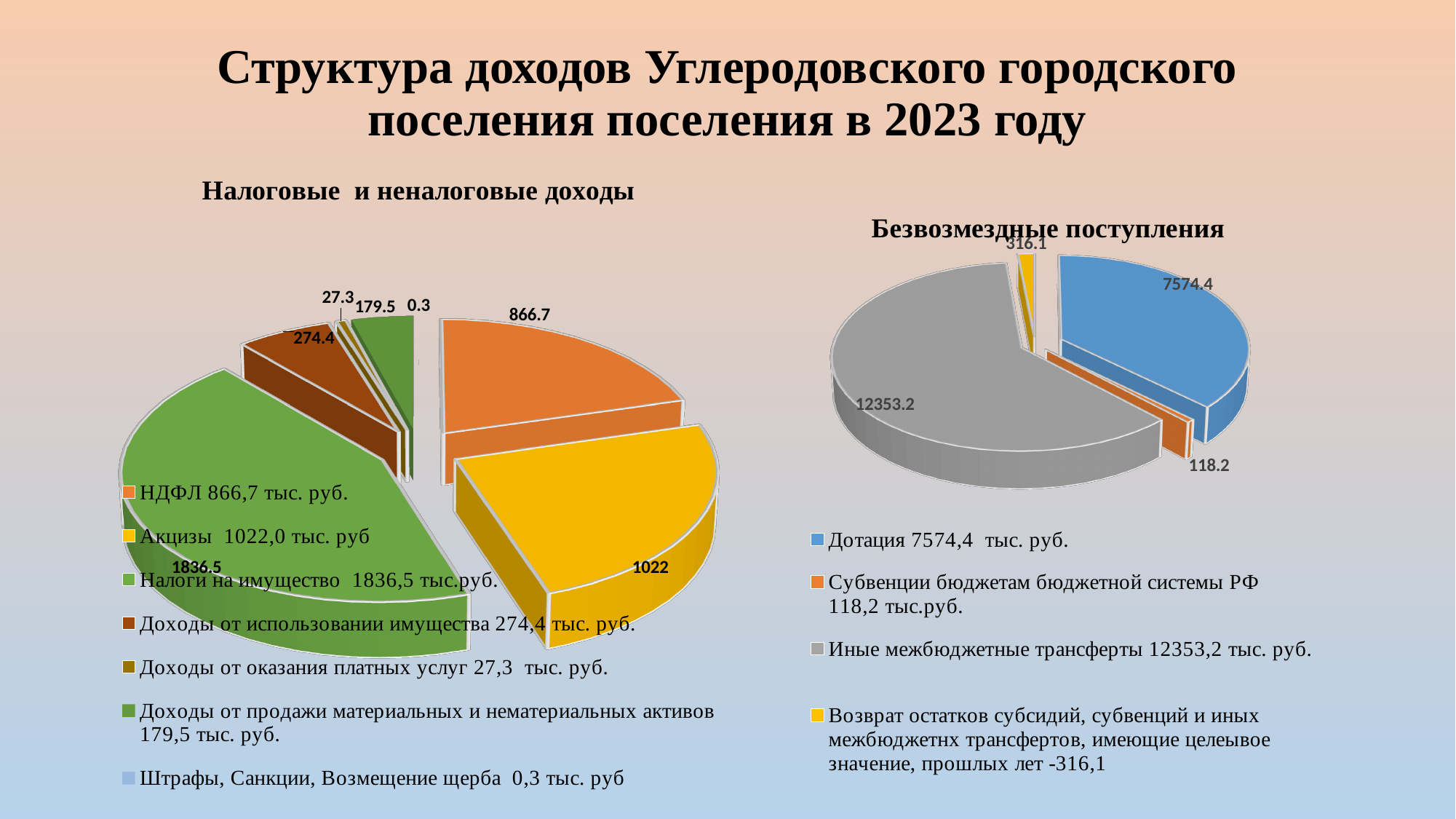
How many categories does the legend of the chart titled "Безвозмездные поступления" list? 4 On the chart titled "Безвозмездные поступления", what is the difference between the values for Иные межбюджетные трансферты and Дотация? 4778.8 On the chart titled "Безвозмездные поступления", what value is shown for Дотация? 7574.4 On the chart titled "Налоговые и неналоговые доходы", which category has the largest slice? Налоги на имущество On the chart titled "Налоговые и неналоговые доходы", what is the difference between the values for Налоги на имущество and Акцизы? 814.5 On the chart titled "Налоговые и неналоговые доходы", which is larger: Доходы от использовании имущества or Доходы от продажи материальных и нематериальных активов? Доходы от использовании имущества On the chart titled "Безвозмездные поступления", which category has the largest slice? Иные межбюджетные трансферты On the chart titled "Безвозмездные поступления", what value is shown for Субвенции бюджетам бюджетной системы РФ? 118.2 What type of chart is the chart titled "Налоговые и неналоговые доходы"? Pie chart On the chart titled "Налоговые и неналоговые доходы", what value is shown for Налоги на имущество? 1836.5 On the chart titled "Налоговые и неналоговые доходы", which category has the smallest value? Штрафы, Санкции, Возмещение щерба On the chart titled "Налоговые и неналоговые доходы", what value is shown for НДФЛ? 866.7